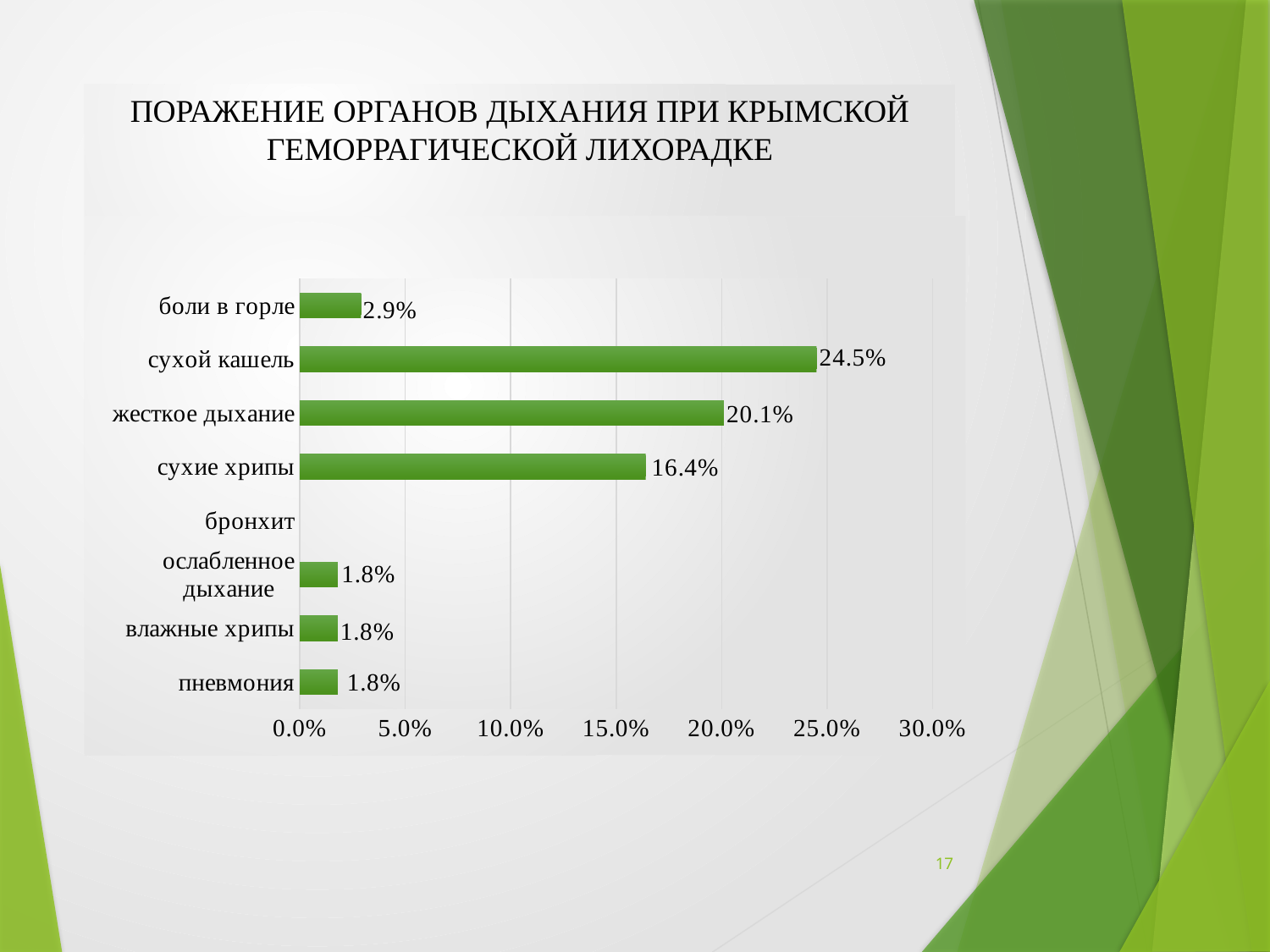
What is the value for боли в горле? 2.9% Which category has the highest value? сухой кашель What is the value for сухой кашель? 24.5% What is the value for сухие хрипы? 16.4% How many categories are shown on the chart? 8 What is the difference between the values for жесткое дыхание and сухие хрипы? 3.7 percentage points Which is larger, the value for сухие хрипы or the value for боли в горле? сухие хрипы Is the value for сухой кашель greater or less than 20.0%? greater What is the value for жесткое дыхание? 20.1% What is the value for пневмония? 1.8% What kind of chart is shown on the slide? bar chart What is the difference between the values for сухой кашель and жесткое дыхание? 4.4 percentage points